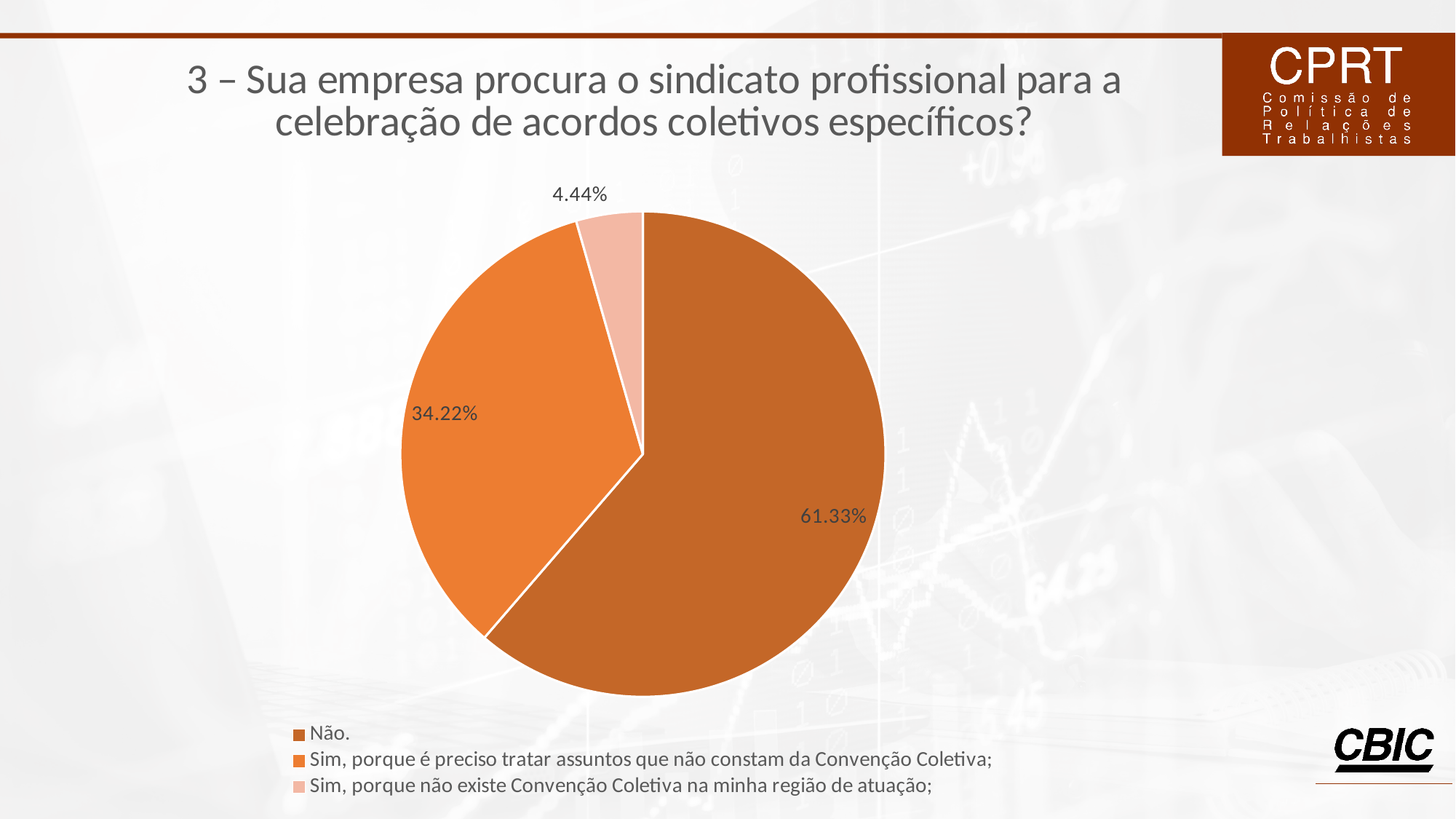
Which is larger: the share for "Sim, porque é preciso tratar assuntos que não constam da Convenção Coletiva;" or the share for "Sim, porque não existe Convenção Coletiva na minha região de atuação;"? Sim, porque é preciso tratar assuntos que não constam da Convenção Coletiva; Which response has the smallest share of the pie? Sim, porque não existe Convenção Coletiva na minha região de atuação; Which response has the largest share of the pie? Não. What question is the chart's title asking? 3 – Sua empresa procura o sindicato profissional para a celebração de acordos coletivos específicos? What percentage corresponds to "Sim, porque é preciso tratar assuntos que não constam da Convenção Coletiva;"? 34.22% What percentage of respondents answered "Não."? 61.33% What is the difference in percentage points between the "Não." slice and the "Sim, porque é preciso tratar assuntos que não constam da Convenção Coletiva;" slice? 27.11 What percentage corresponds to "Sim, porque não existe Convenção Coletiva na minha região de atuação;"? 4.44% What is the combined percentage of the two "Sim" responses? 38.66% What type of chart is shown on the slide? pie chart How many entries does the legend list? 3 How many slices does the pie chart have? 3